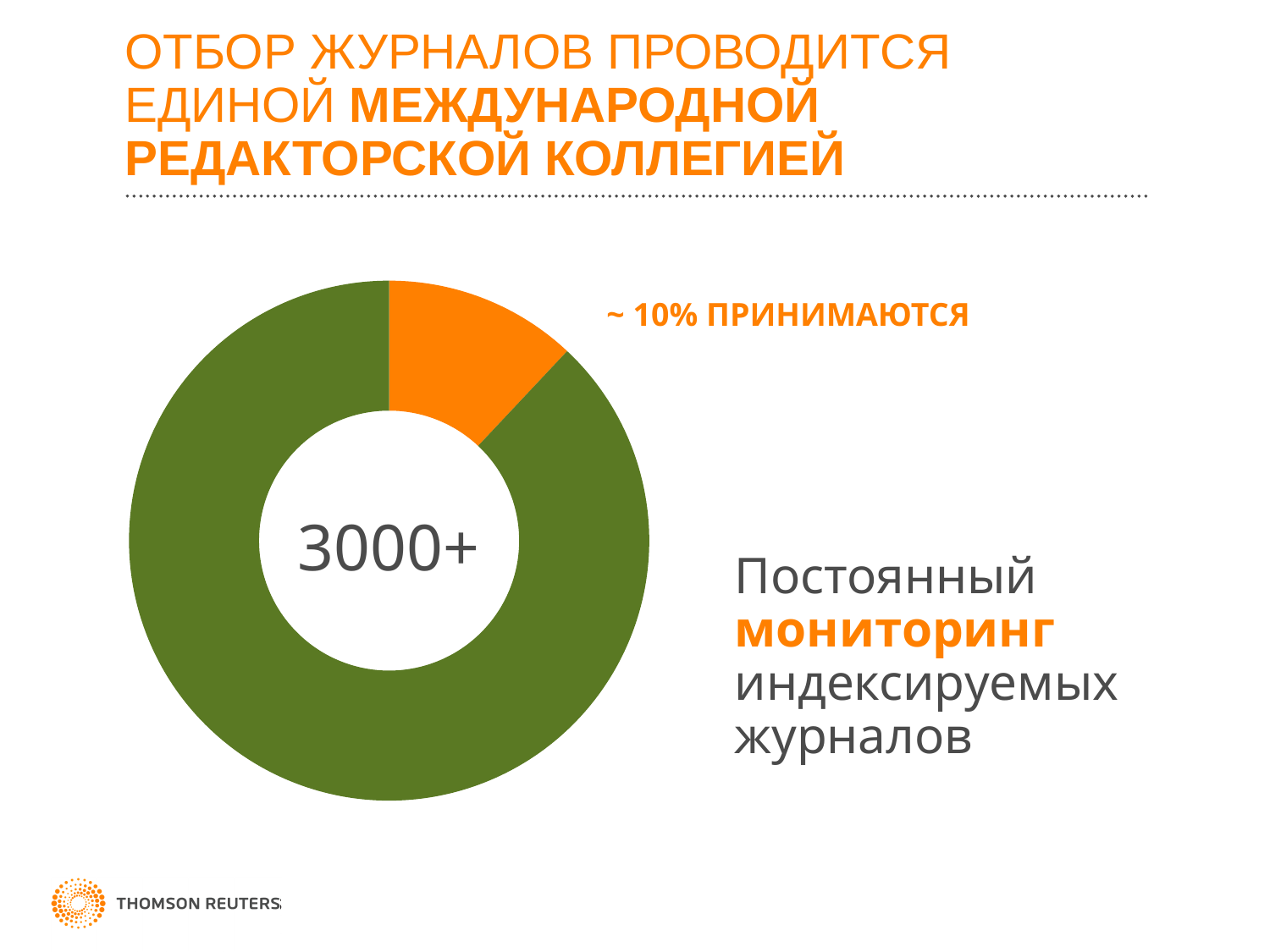
Which colour is the smallest slice of the donut chart? orange What text appears to the right of the donut chart, below the slice label? Постоянный мониторинг индексируемых журналов What two colours are used for the slices of the donut chart? green and orange Which slice of the donut chart is larger, the green one or the orange one? the green one What label is printed next to the orange slice of the donut chart? ~ 10% ПРИНИМАЮТСЯ What number is printed in the centre of the donut chart? 3000+ How many slices does the donut chart have? 2 Is the orange slice of the donut chart greater or less than half of the chart? less Which colour is the largest slice of the donut chart? green What kind of chart is shown on the slide? donut chart